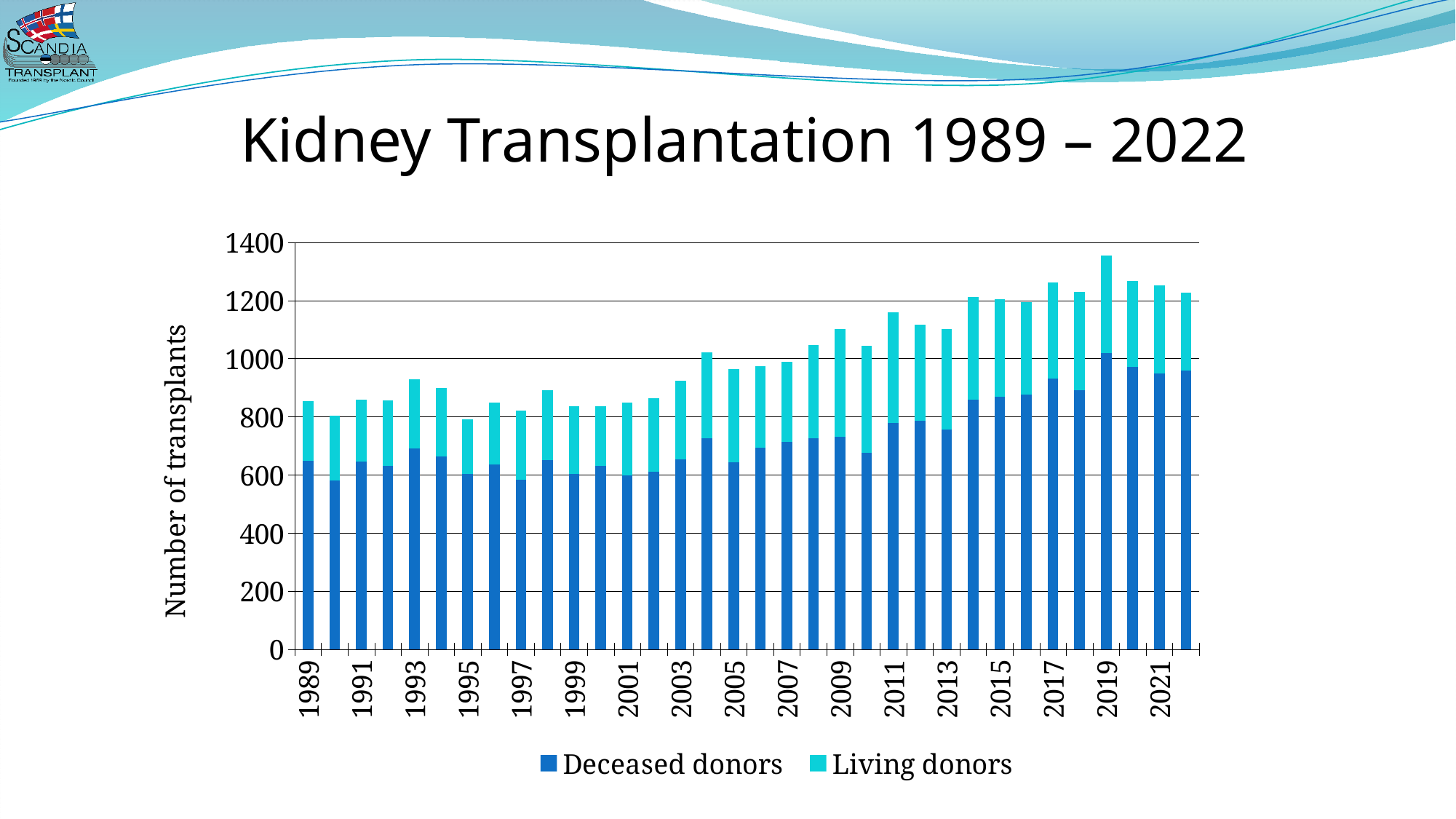
Which year has the highest total number of kidney transplants? 2019 Is the number of transplants from deceased donors in 2019 greater or less than 1000? greater How many years (bars) are plotted in the chart? 34 What is the label on the vertical axis of the chart? Number of transplants Is the total number of transplants in 2019 greater or less than 1200? greater Which year has the larger total number of transplants, 2019 or 2022? 2019 Which series is shown in the lighter cyan colour in the legend? Living donors Is the total number of transplants in 1989 greater or less than 1000? less Overall, do total kidney transplants rise or fall from 1989 to 2022? rise How many series does the legend list? 2 What kind of chart is shown on the slide? Stacked bar chart